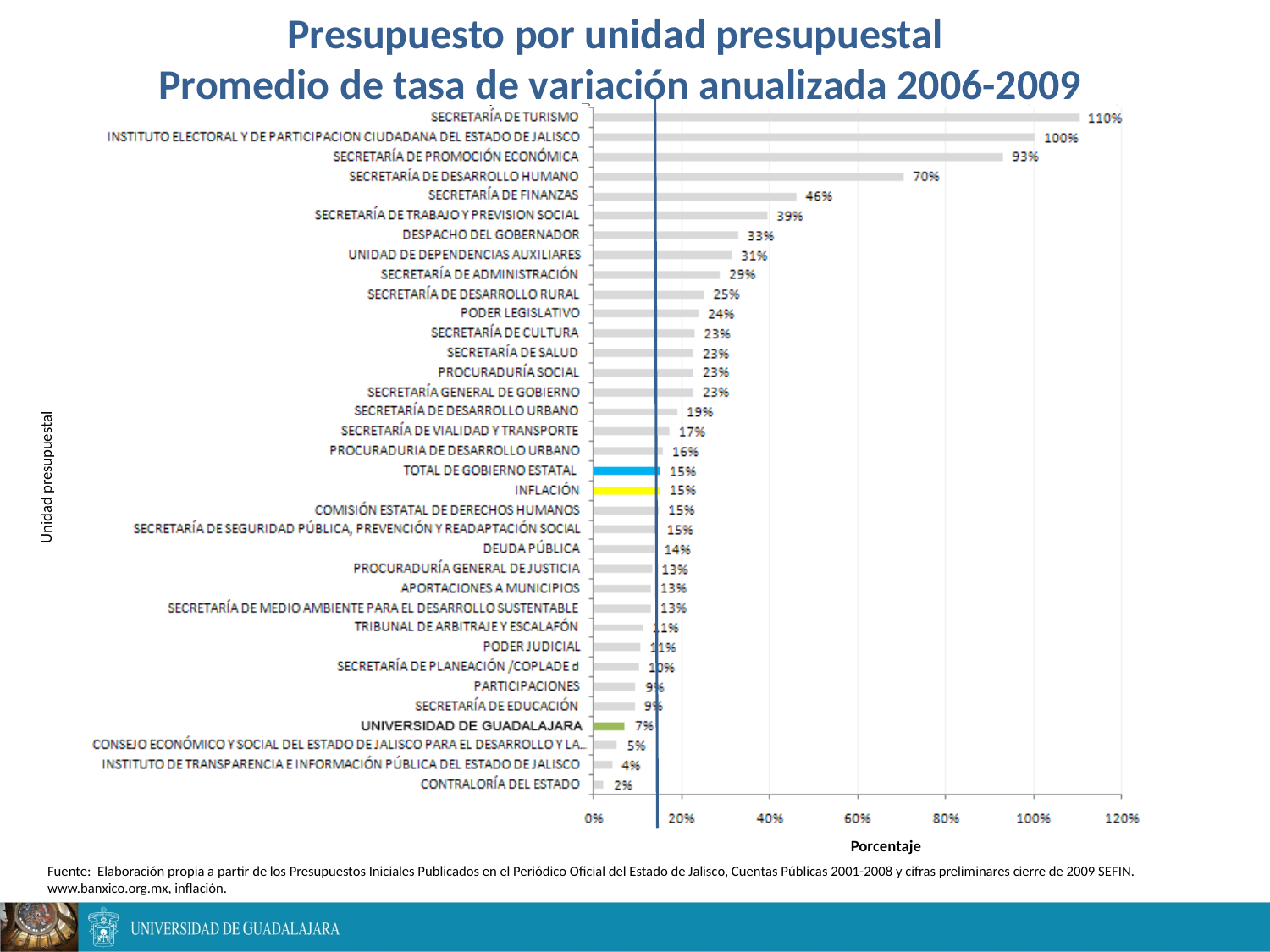
Which is larger, the value for DESPACHO DEL GOBERNADOR or the value for PODER LEGISLATIVO? DESPACHO DEL GOBERNADOR Is the value for SECRETARÍA DE PROMOCIÓN ECONÓMICA greater or less than 80%? greater What is the value for UNIVERSIDAD DE GUADALAJARA? 7% What is the value for SECRETARÍA DE TURISMO? 110% What kind of chart is shown on the slide? Bar chart Which category has the lowest value? CONTRALORÍA DEL ESTADO Which category has the highest value? SECRETARÍA DE TURISMO What is the value for INFLACIÓN? 15% What is the value for SECRETARÍA DE FINANZAS? 46% What is the difference between the values for SECRETARÍA DE TURISMO and SECRETARÍA DE DESARROLLO HUMANO? 40% What is the label of the horizontal axis? Porcentaje How many categories are shown in the chart? 35